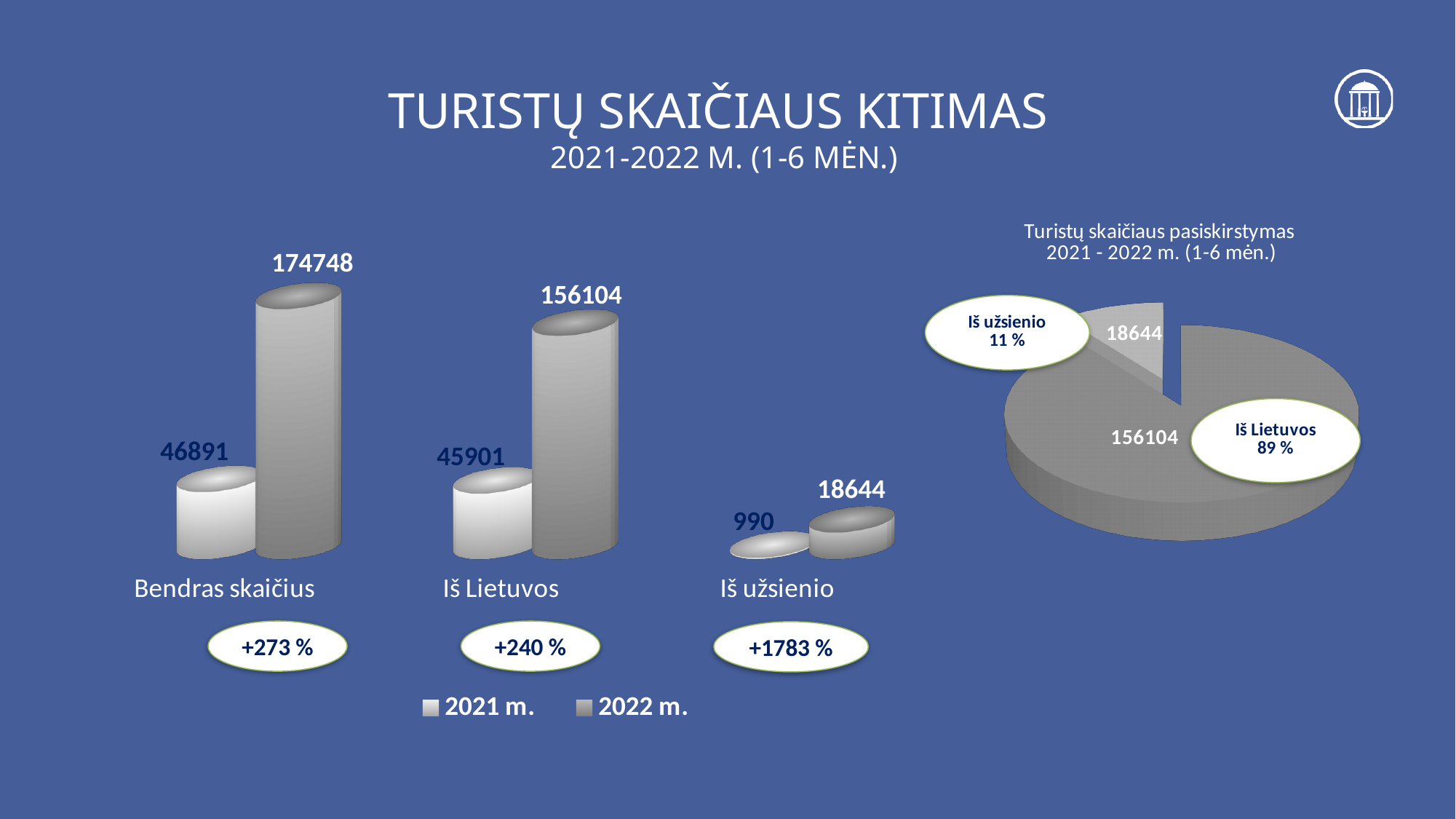
In the bar chart on the left, what is the value for Bendras skaičius in 2022 m.? 174748 What kind of chart is the chart on the right titled 'Turistų skaičiaus pasiskirstymas'? Pie chart In the pie chart on the right, what share of the total does Iš Lietuvos represent? 89 % In the bar chart on the left, which category has the highest value for 2021 m.? Bendras skaičius In the bar chart on the left, which is larger: the 2022 m. value for Iš Lietuvos or the 2021 m. value for Bendras skaičius? 2022 m. value for Iš Lietuvos In the bar chart on the left, what is the value for Iš Lietuvos in 2021 m.? 45901 In the bar chart on the left, which category has the lowest value for 2022 m.? Iš užsienio How many series does the legend of the bar chart on the left list? 2 How many categories are shown in the bar chart on the left? 3 In the bar chart on the left, what is the value for Iš užsienio in 2021 m.? 990 In the bar chart on the left, what is the difference between the 2022 m. and 2021 m. values for Iš užsienio? 17654 In the pie chart on the right, what is the value shown for the Iš užsienio slice? 18644